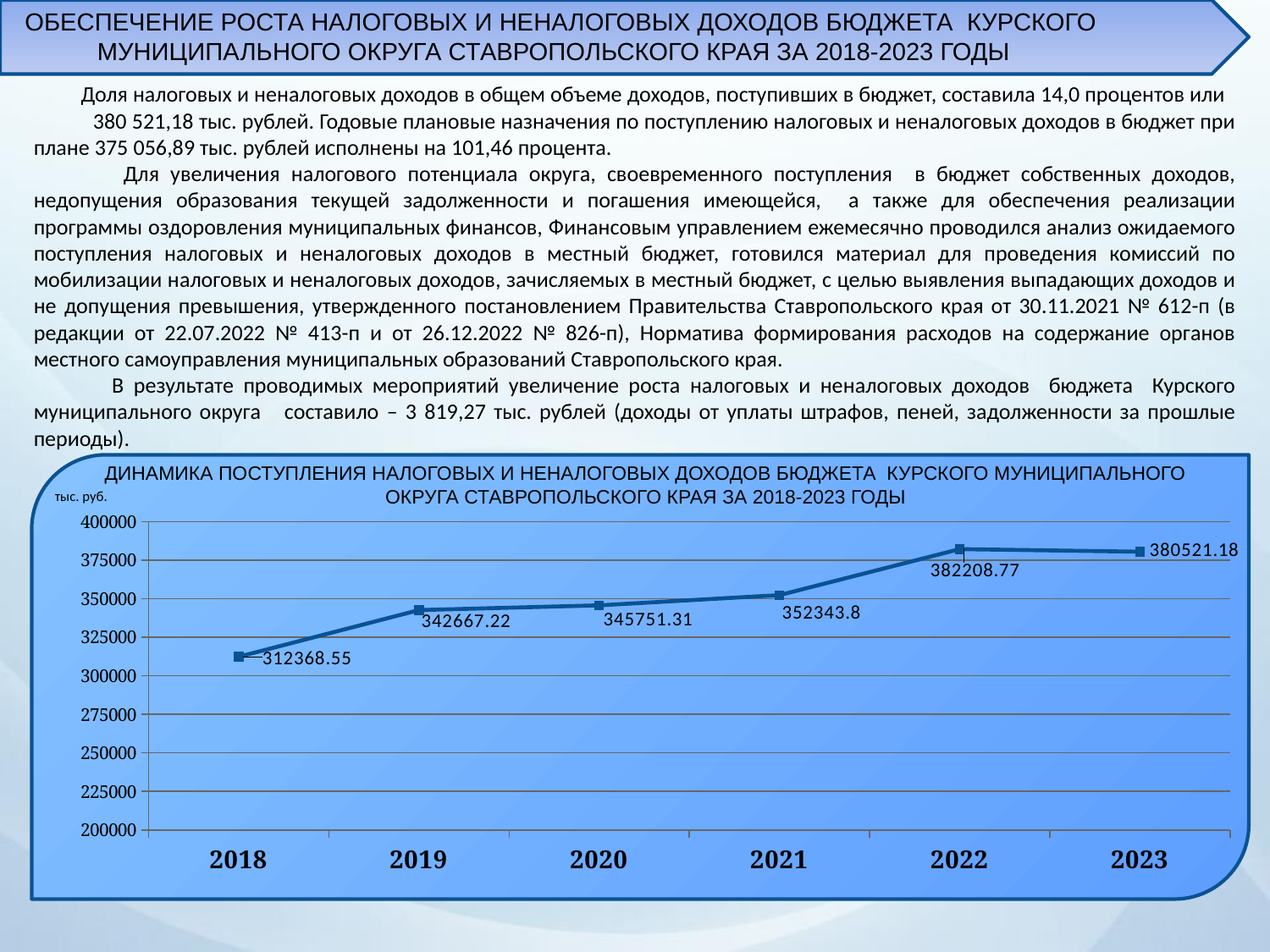
What is the value for 2018 on the chart? 312368.55 What is the difference between the values for 2022 and 2021? 29864.97 How many years are plotted on the chart? 6 Do the values rise or fall from 2018 to 2022? rise Which is larger, the value for 2022 or the value for 2023? 2022 Which year has the highest value on the chart? 2022 What is the value for 2021 on the chart? 352343.8 What is the value for 2023 on the chart? 380521.18 Is the value for 2020 greater or less than 350000? less What is the difference between the values for 2023 and 2018? 68152.63 Which year has the lowest value on the chart? 2018 What kind of chart is shown on the slide? line chart